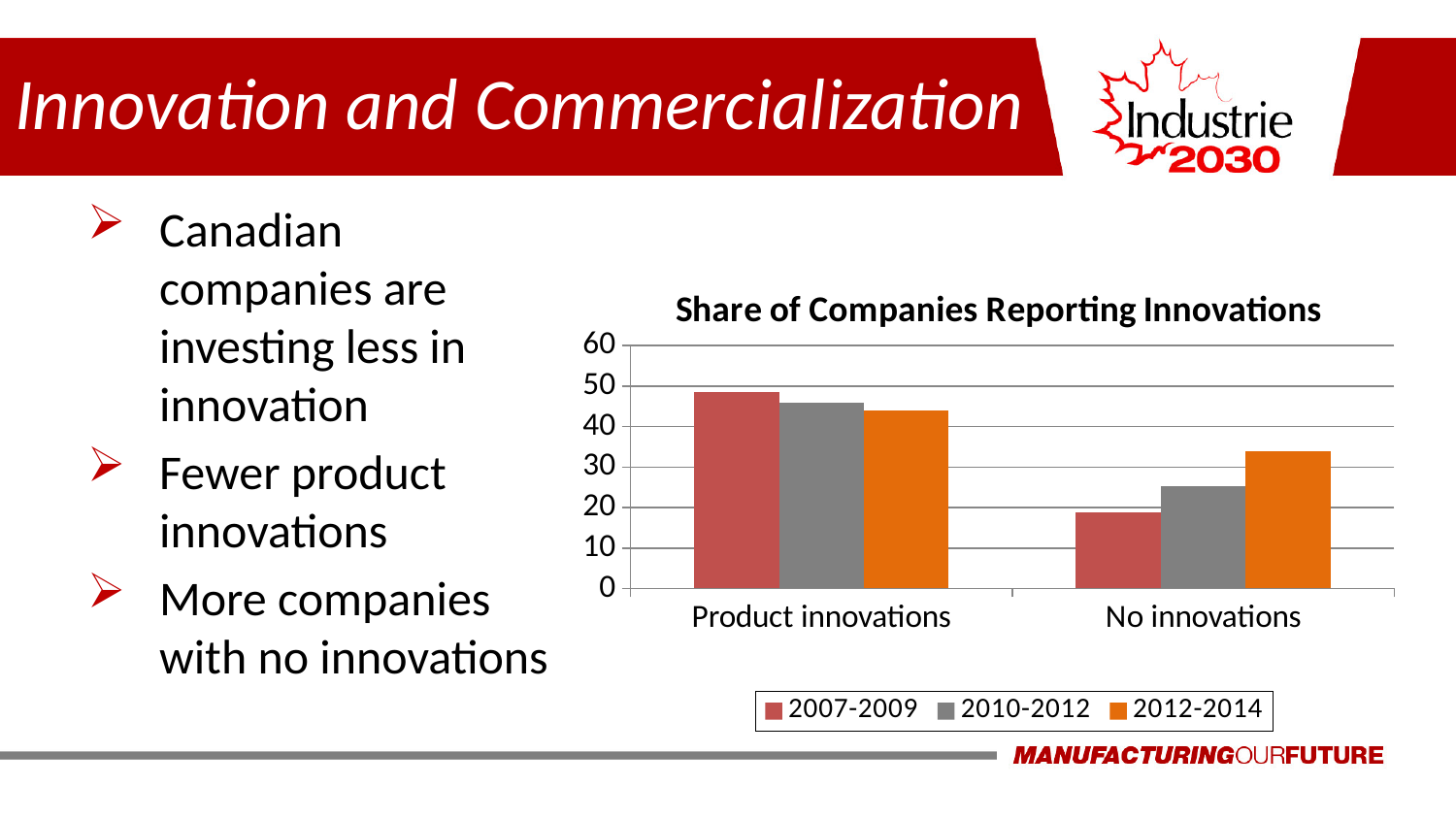
Which period has the lowest value for Product innovations? 2012-2014 Is the value for Product innovations in 2007-2009 greater or less than 40? greater What is the title of the chart? Share of Companies Reporting Innovations How many categories are shown on the x axis of the chart? 2 Which series is shown in orange in the chart? 2012-2014 Is the value for Product innovations in 2012-2014 greater or less than 50? less Is the value for No innovations in 2012-2014 greater or less than 30? greater What kind of chart is shown on the slide? bar chart Across the three periods, do the values for No innovations rise or fall? rise How many series does the chart legend list? 3 Which period has the highest value for No innovations? 2012-2014